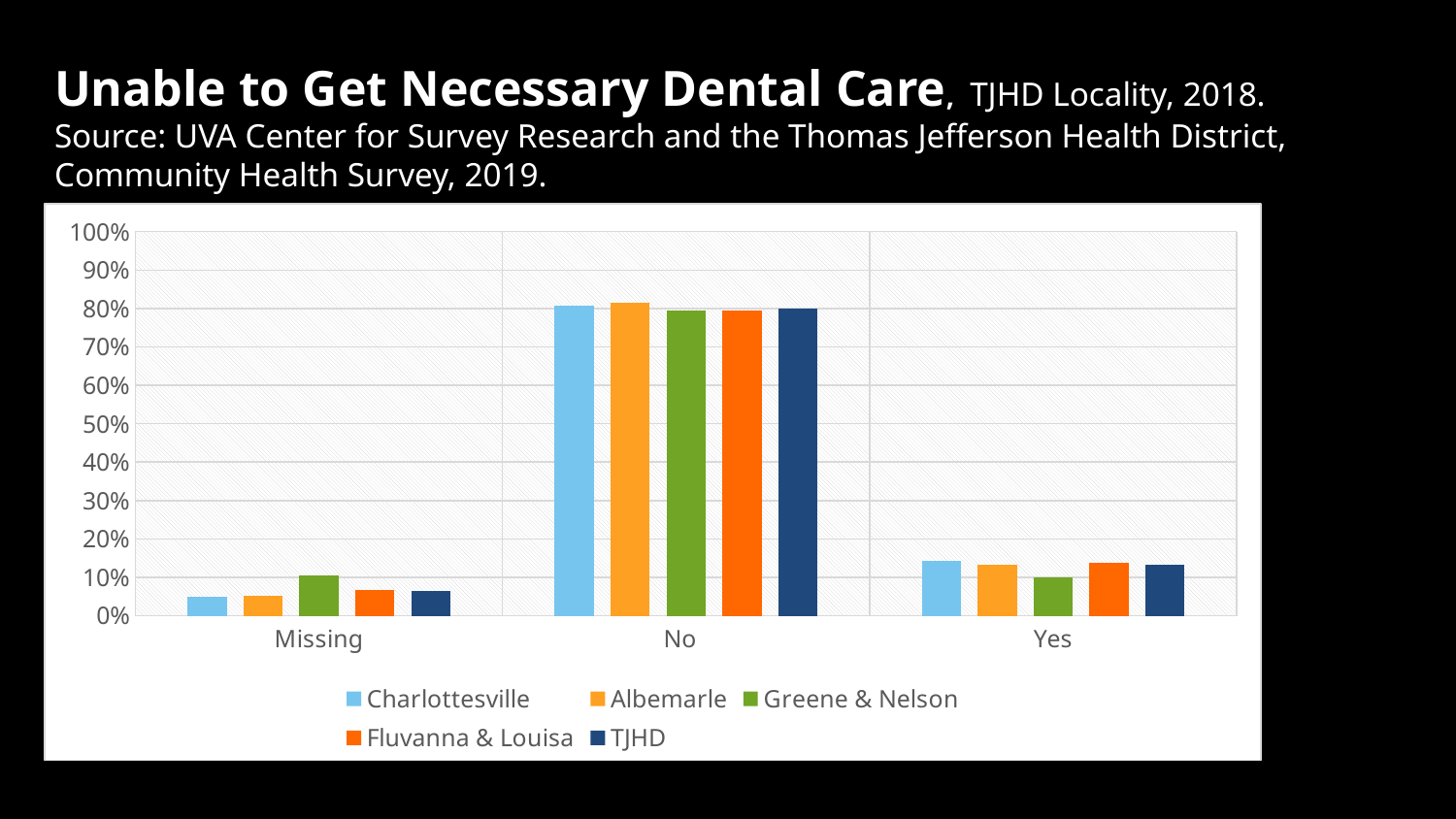
Which series has the highest value in the Missing category? Greene & Nelson Is the value for Charlottesville in the No category greater or less than 50%? greater Which series is shown in dark blue in the legend? TJHD What kind of chart is shown on the slide? bar chart Which series has the lowest value in the Yes category? Greene & Nelson Is the value for TJHD in the No category greater or less than 70%? greater How many series does the legend list? 5 How many categories are shown on the x axis? 3 Which category on the x axis has the highest values across all series? No In the Missing category, which is larger: Greene & Nelson or Charlottesville? Greene & Nelson Is the value for Greene & Nelson in the Missing category greater or less than 5%? greater